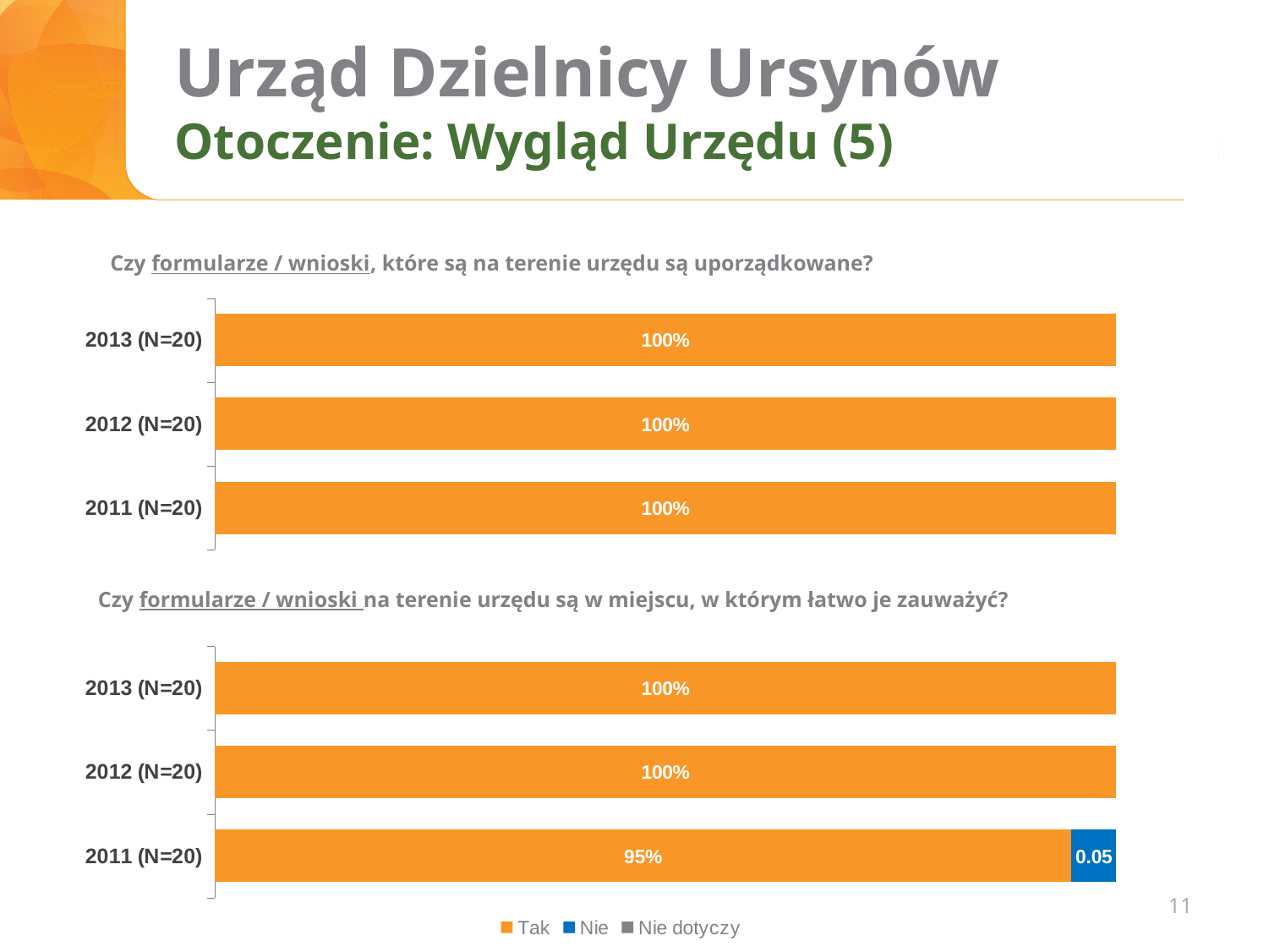
In the bottom chart ("Czy formularze / wnioski na terenie urzędu są w miejscu, w którym łatwo je zauważyć?"), what is the Tak value for 2012 (N=20)? 100% How many year categories does the top chart ("Czy formularze / wnioski, które są na terenie urzędu są uporządkowane?") show? 3 In the bottom chart ("Czy formularze / wnioski na terenie urzędu są w miejscu, w którym łatwo je zauważyć?"), what is the Nie value for 2011 (N=20)? 0.05 In the bottom chart ("Czy formularze / wnioski na terenie urzędu są w miejscu, w którym łatwo je zauważyć?"), what is the difference between the Tak value for 2013 (N=20) and the Tak value for 2011 (N=20)? 5% What are the legend entries shown at the bottom of the slide? Tak, Nie, Nie dotyczy In the top chart ("Czy formularze / wnioski, które są na terenie urzędu są uporządkowane?"), what is the value for 2013 (N=20)? 100% In the bottom chart ("Czy formularze / wnioski na terenie urzędu są w miejscu, w którym łatwo je zauważyć?"), which year has the lowest Tak value? 2011 (N=20) In the bottom chart ("Czy formularze / wnioski na terenie urzędu są w miejscu, w którym łatwo je zauważyć?"), what is the Tak value for 2011 (N=20)? 95% In the top chart ("Czy formularze / wnioski, które są na terenie urzędu są uporządkowane?"), what is the value for 2011 (N=20)? 100% What type of chart is the bottom chart ("Czy formularze / wnioski na terenie urzędu są w miejscu, w którym łatwo je zauważyć?")? bar chart In the bottom chart ("Czy formularze / wnioski na terenie urzędu są w miejscu, w którym łatwo je zauważyć?"), is the Tak value for 2012 (N=20) larger or smaller than the Tak value for 2011 (N=20)? larger How many series does the legend at the bottom of the slide list? 3